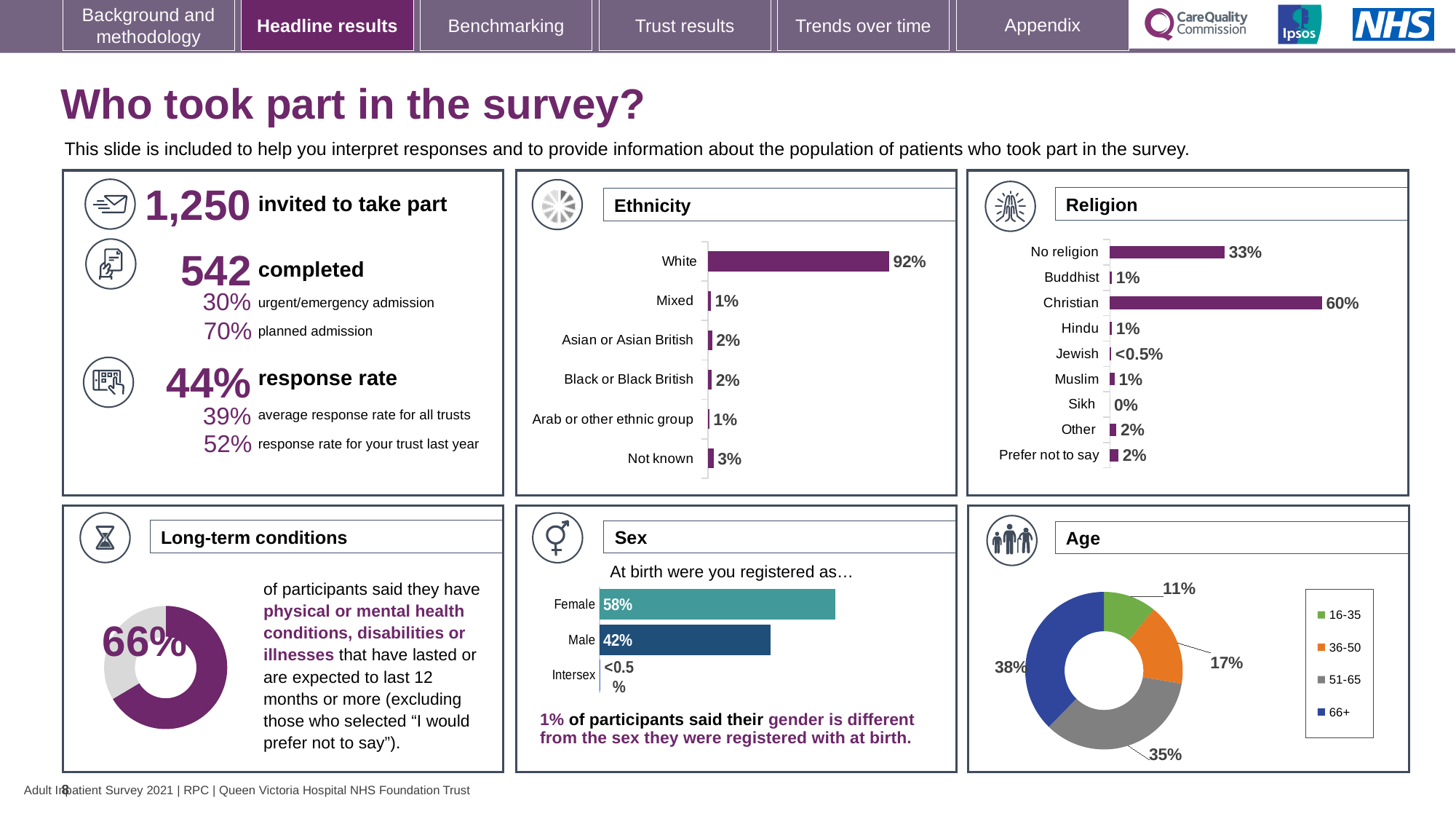
How many categories are shown in the Religion chart? 9 In the Ethnicity chart, which category has the highest value? White In the Sex chart, which is larger, Female or Male? Female In the Age chart, what share of participants were aged 51-65? 35% How many categories are shown in the Ethnicity chart? 6 In the Ethnicity chart, what is the value for Not known? 3% In the Religion chart, what is the difference between Christian and No religion? 27% In the Religion chart, what is the value for Jewish? <0.5% In the Ethnicity chart, what percentage of participants were White? 92% In the Religion chart, what percentage of participants were Christian? 60% How many series does the legend of the Age chart list? 4 In the Sex chart, what is the difference between Female and Male? 16%